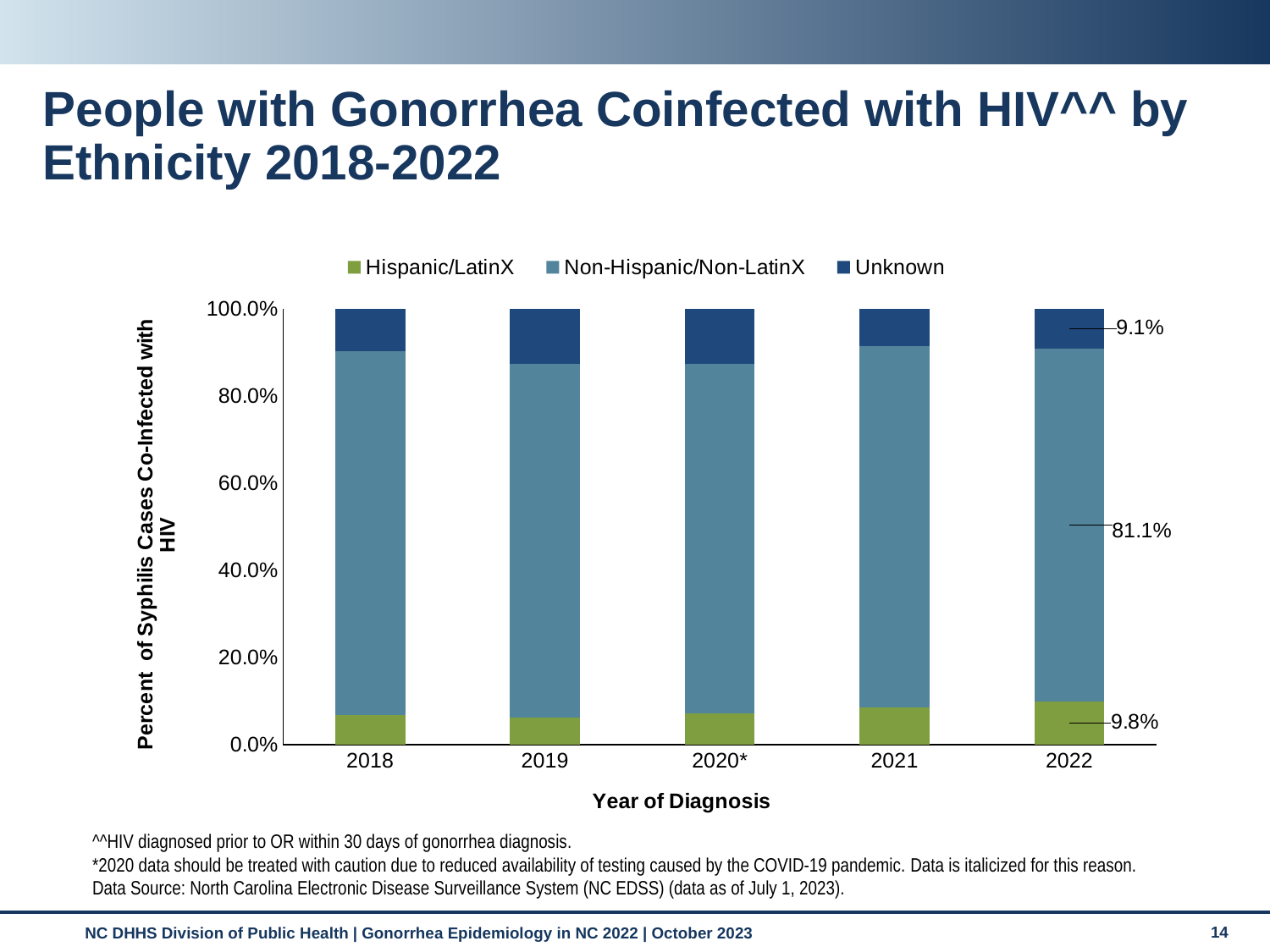
What is the difference between the Hispanic/LatinX share and the Unknown share in 2022? 0.7% What kind of chart is shown on the slide? Stacked bar chart What percentage of the 2022 bar is Non-Hispanic/Non-LatinX? 81.1% What percentage of the 2022 bar is Hispanic/LatinX? 9.8% What percentage of the 2022 bar is Unknown? 9.1% Is the Hispanic/LatinX share in 2018 greater or less than 20.0%? less In 2022, which is larger: the Hispanic/LatinX share or the Unknown share? Hispanic/LatinX What is the difference between the Non-Hispanic/Non-LatinX share and the Hispanic/LatinX share in 2022? 71.3% How many series does the legend list? 3 How many years are shown on the x axis? 5 What is the title of the x axis? Year of Diagnosis Is the top of the Non-Hispanic/Non-LatinX segment in 2018 greater or less than 80.0%? greater